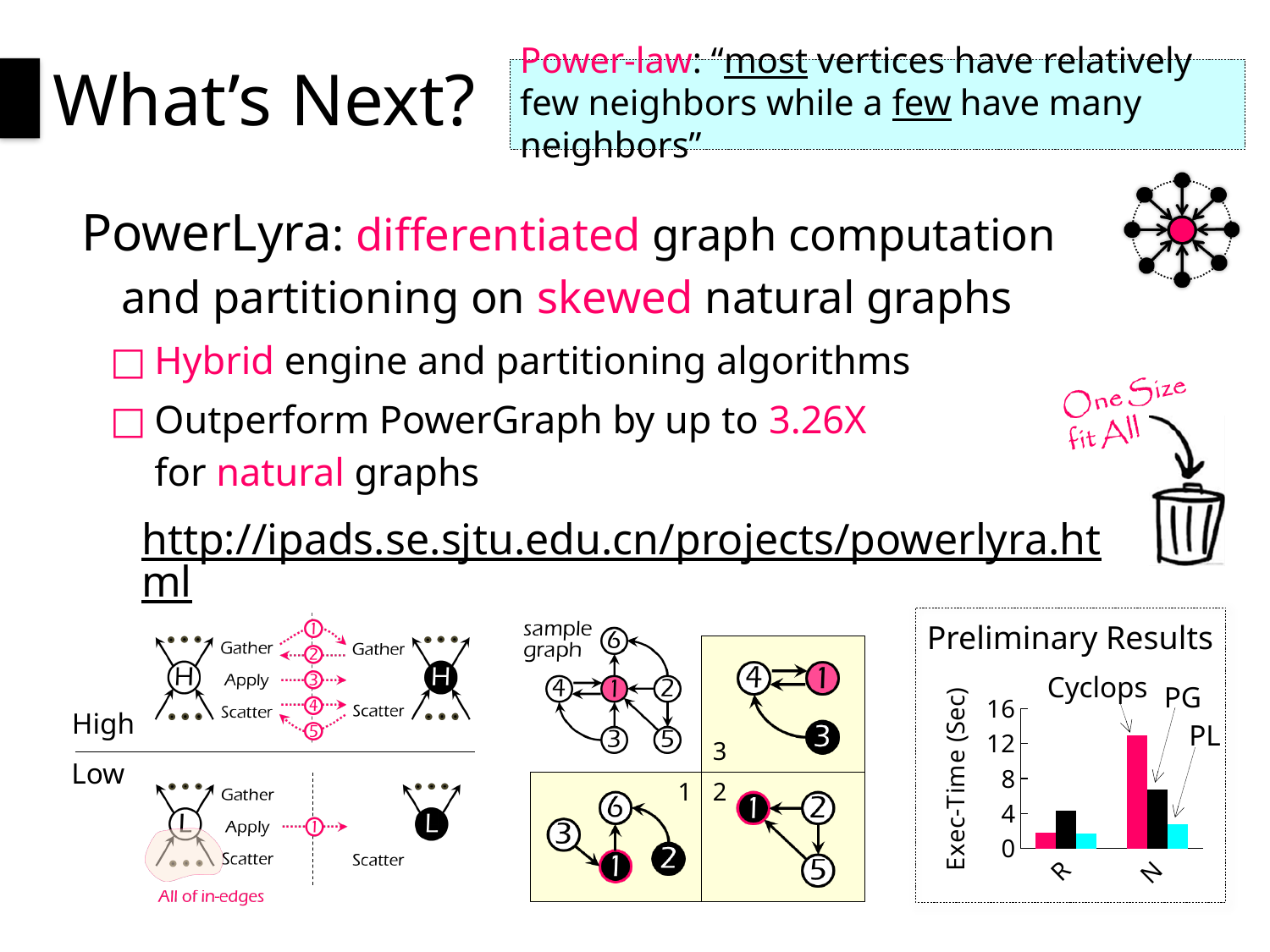
In the Preliminary Results chart, is the PL value for N greater or less than 4? less In the Preliminary Results chart, which series has the highest value for N? Cyclops In the Preliminary Results chart, is the Cyclops value for N greater or less than 8? greater In the Preliminary Results chart, which is larger for N: Cyclops or PG? Cyclops In the Preliminary Results chart, does the Cyclops value rise or fall from R to N? rise In the Preliminary Results chart, how many series are labelled? 3 In the Preliminary Results chart, which series has the lowest value for N? PL In the Preliminary Results chart, is the PG value for N greater or less than 8? less In the Preliminary Results chart, which series has the highest value for R? PG In the Preliminary Results chart, how many categories are shown on the x axis? 2 What kind of chart is shown under the title "Preliminary Results"? bar chart What is the y-axis label of the Preliminary Results chart? Exec-Time (Sec)